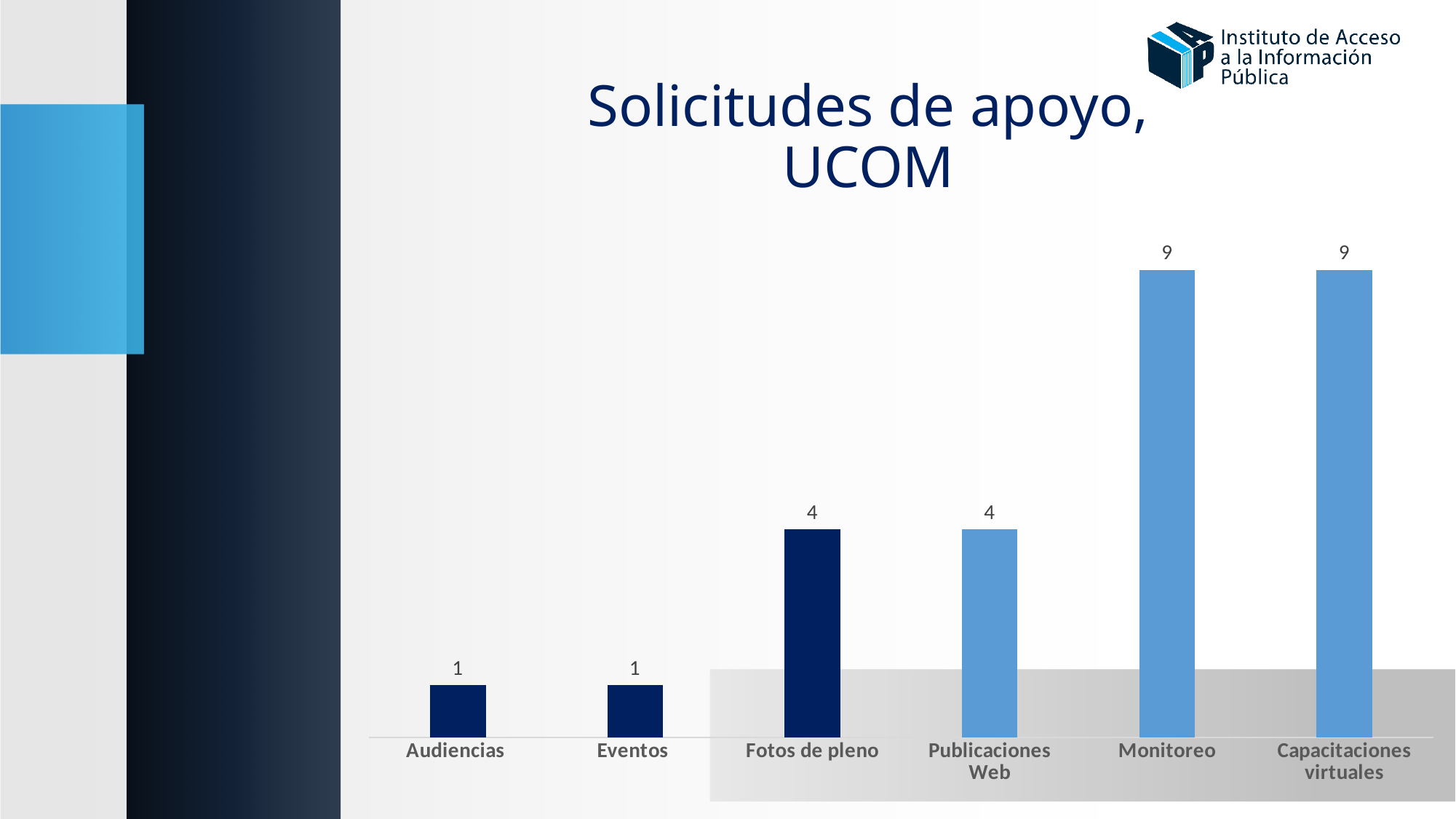
What is the value for Monitoreo? 9 What is the difference between the values for Publicaciones Web and Eventos? 3 What is the title of the chart? Solicitudes de apoyo, UCOM Which categories have the highest value? Monitoreo and Capacitaciones virtuales What is the value for Audiencias? 1 What kind of chart is shown on the slide? Bar chart What is the difference between the values for Monitoreo and Fotos de pleno? 5 Which categories have the lowest value? Audiencias and Eventos Which is larger, the value for Capacitaciones virtuales or the value for Publicaciones Web? Capacitaciones virtuales How many categories are shown in the chart? 6 What is the value for Publicaciones Web? 4 What is the value for Fotos de pleno? 4